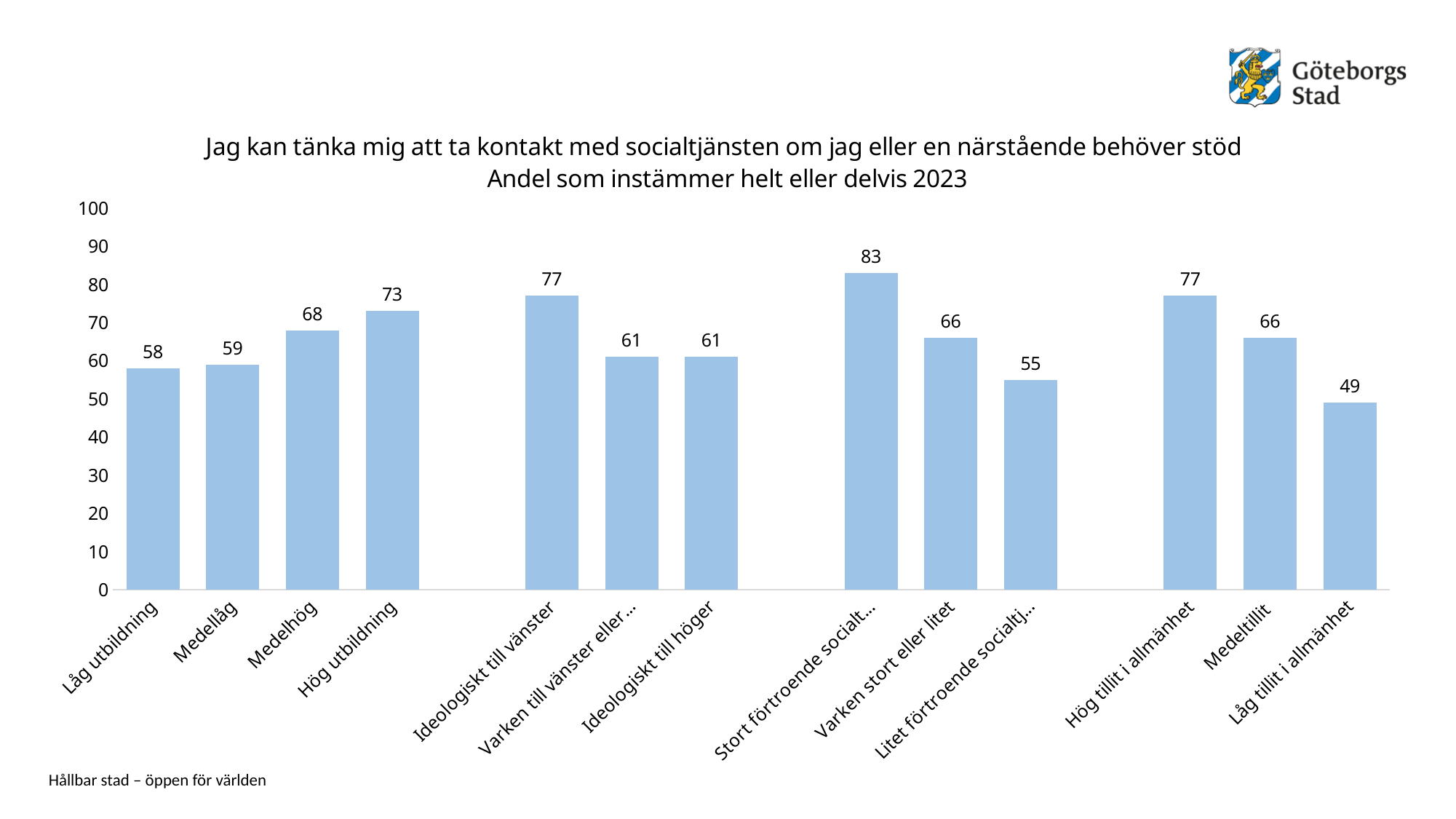
What is the value for Låg utbildning? 58 What is the value for Hög utbildning? 73 Which is larger, the value for Medelhög or the value for Ideologiskt till höger? Medelhög What is the difference between the values for Hög tillit i allmänhet and Låg tillit i allmänhet? 28 What is the value for Ideologiskt till vänster? 77 What is the value for Medeltillit? 66 Which category has the lowest value? Låg tillit i allmänhet How many bars are shown in the chart? 13 What is the highest value shown in the chart? 83 What year is referred to in the chart title? 2023 What is the difference between the values for Hög utbildning and Låg utbildning? 15 What kind of chart is shown on the slide? bar chart